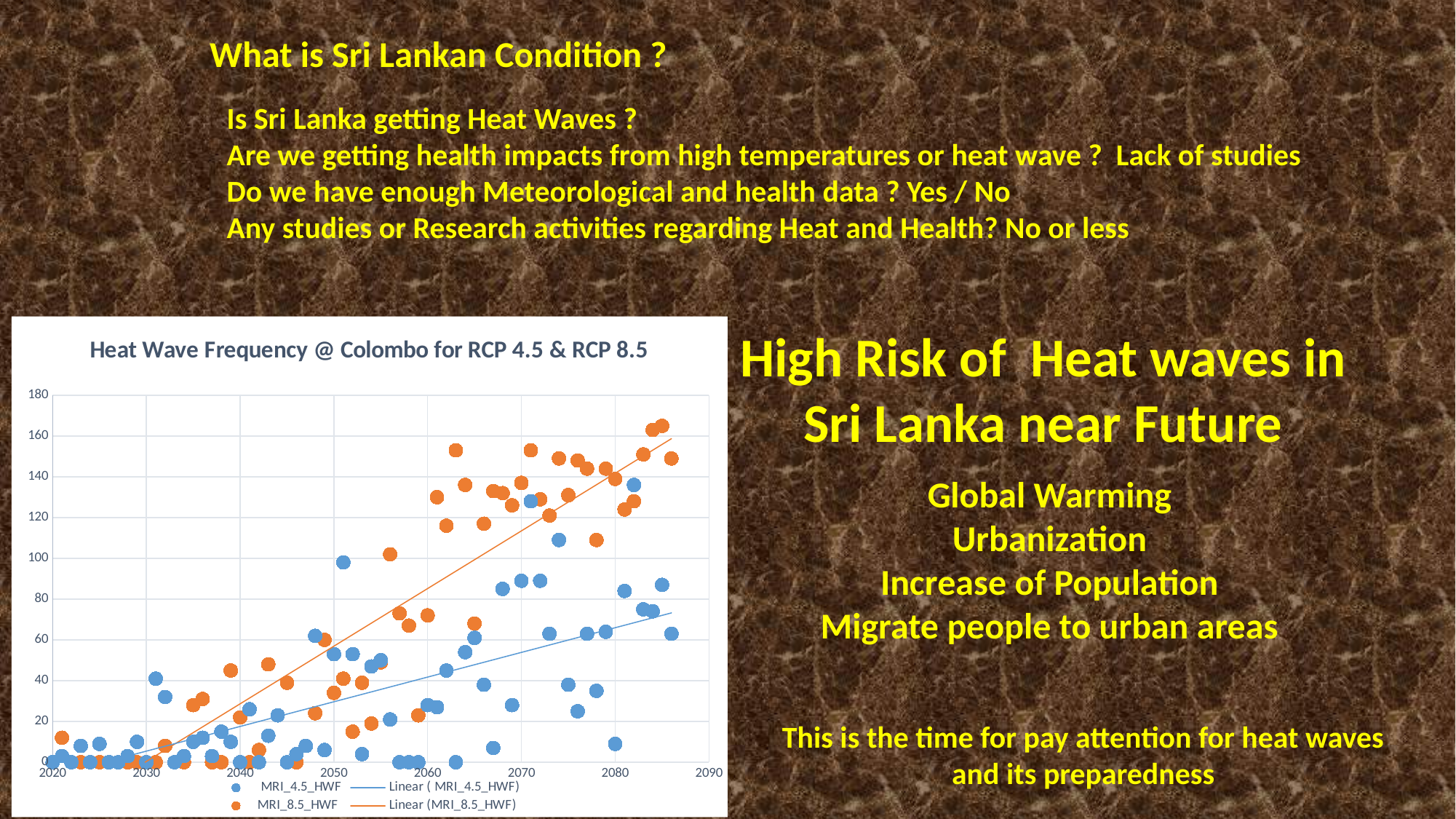
What is the maximum value shown on the vertical axis? 180 Which series has the steeper linear trendline, MRI_4.5_HWF or MRI_8.5_HWF? MRI_8.5_HWF Do the heat wave frequency values generally rise or fall from 2020 to 2090? Rise How many entries does the chart legend list? 4 Which series reaches higher values after 2060, MRI_4.5_HWF or MRI_8.5_HWF? MRI_8.5_HWF What kind of chart is shown on the slide? Scatter chart Is the MRI_4.5_HWF trendline value at 2080 greater or less than 100? less Is the highest MRI_4.5_HWF point greater or less than 120? greater Are the MRI_8.5_HWF values around 2020 greater or less than 20? less What is the title of the chart? Heat Wave Frequency @ Colombo for RCP 4.5 & RCP 8.5